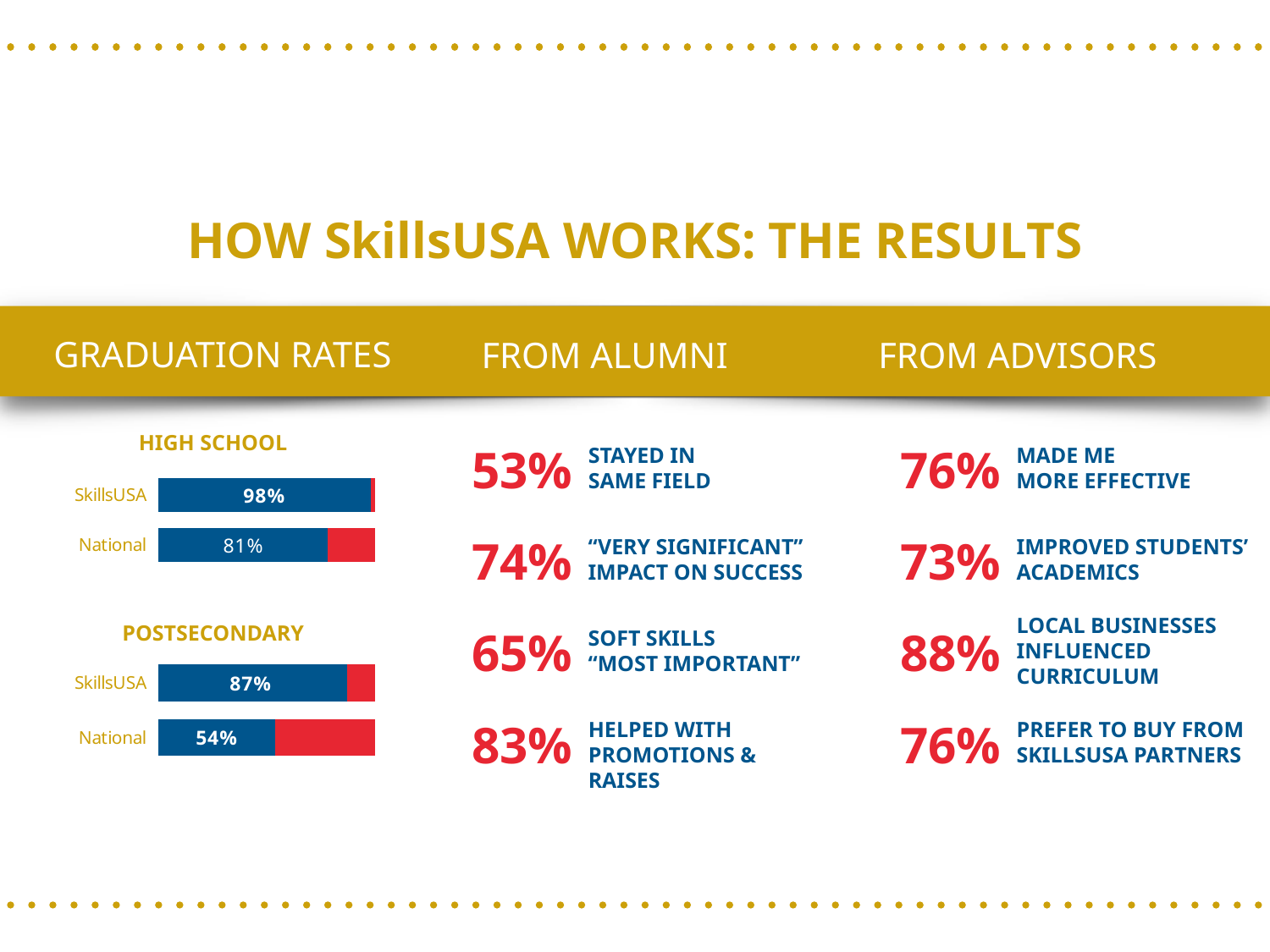
In the Postsecondary graduation rates chart, what is the value for SkillsUSA? 87% What is the title of the chart showing the 87% and 54% graduation rates? POSTSECONDARY In the High School graduation rates chart, what is the value for National? 81% In the High School graduation rates chart, what is the value for SkillsUSA? 98% In the Postsecondary graduation rates chart, which category has the lower value? National In the Postsecondary graduation rates chart, what is the difference between the SkillsUSA and National values? 33% In the Postsecondary graduation rates chart, what is the value for National? 54% How many categories are shown in the Postsecondary graduation rates chart? 2 In the High School graduation rates chart, which category has the higher value? SkillsUSA Is the SkillsUSA value in the Postsecondary chart larger or smaller than the SkillsUSA value in the High School chart? smaller In the High School graduation rates chart, what is the difference between the SkillsUSA and National values? 17% What kind of chart is used to show the High School graduation rates? bar chart